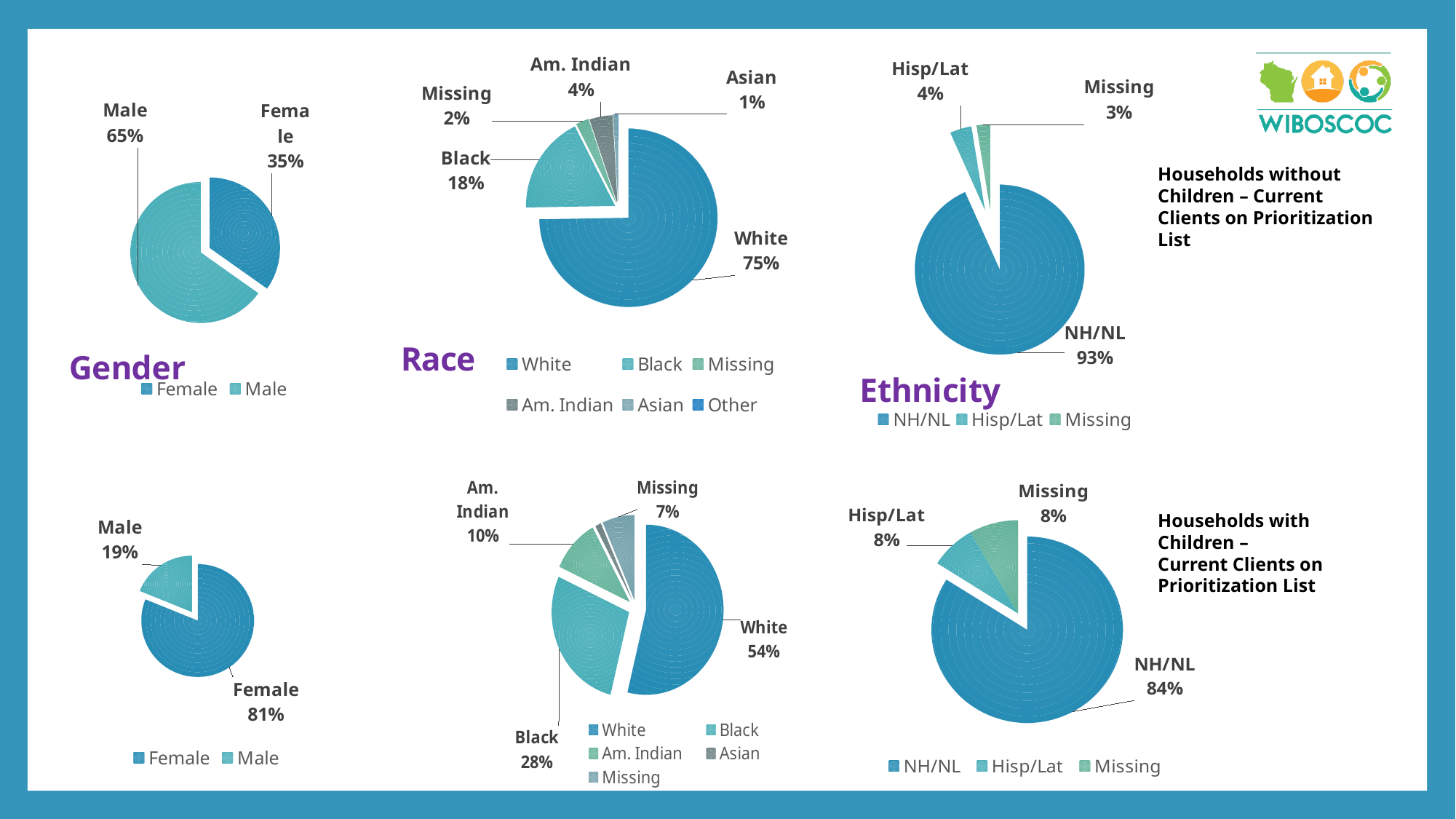
In the top Ethnicity pie chart (Households without Children), what is the difference between the Hisp/Lat and Missing shares? 1% In the top Race pie chart (Households without Children), what share is Black? 18% In the top-left Gender pie chart (Households without Children), what share is Male? 65% In the bottom Race pie chart (Households with Children), what is the difference between the White and Black shares? 26% How many pie charts are shown on the slide? 6 In the bottom Race pie chart (Households with Children), which is larger, Am. Indian or Missing? Am. Indian How many entries does the legend of the top Race pie chart (Households without Children) list? 6 In the top Ethnicity pie chart (Households without Children), what share is NH/NL? 93% In the top Race pie chart (Households without Children), which category has the smallest labelled slice? Asian In the bottom Ethnicity pie chart (Households with Children), what share is Hisp/Lat? 8% What type of chart is used for the Gender data on this slide? Pie chart In the bottom-left Gender pie chart (Households with Children), what share is Female? 81%